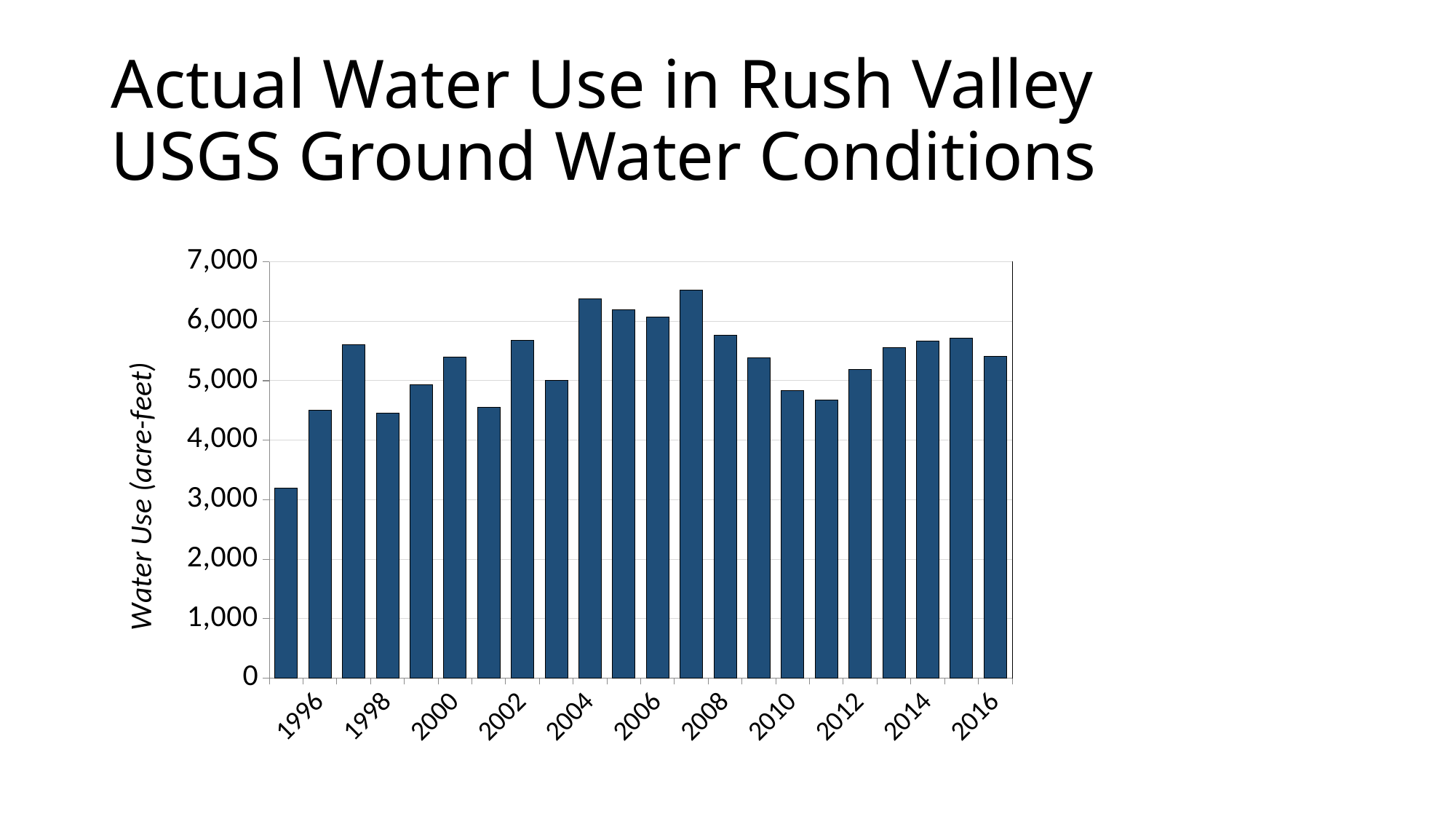
What kind of chart is shown on the slide? bar chart Which year had higher water use, 2005 or 2011? 2005 What is the label on the vertical axis of the chart? Water Use (acre-feet) Which year has the highest water use? 2007 Which year has the lowest water use? 1995 Is the water use for 1996 greater or less than 4,000 acre-feet? greater Is the water use for 2012 greater or less than 5,000 acre-feet? greater How many bars (years) are plotted in the chart? 22 Is the water use for 1998 greater or less than 5,000 acre-feet? less